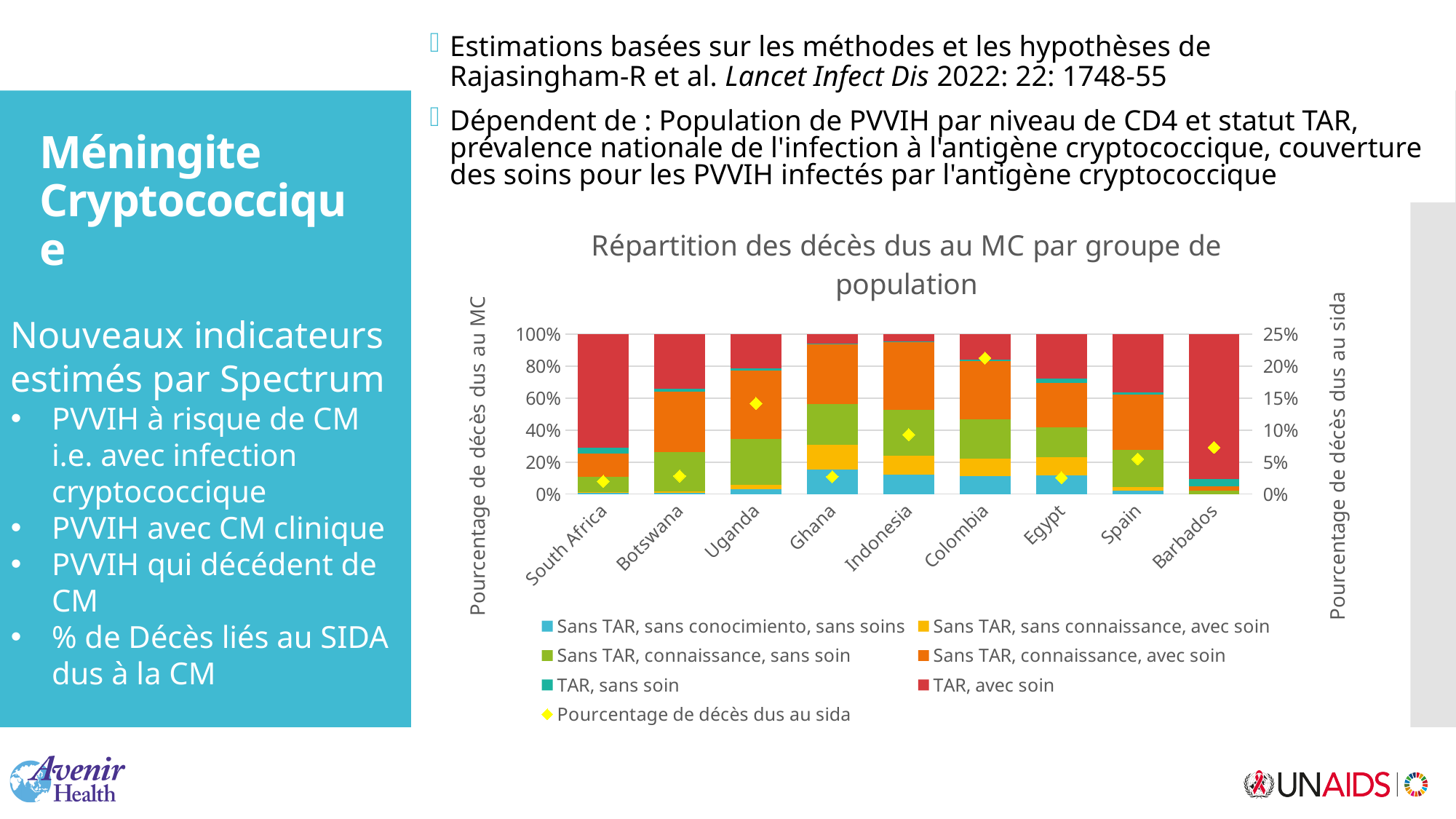
What is the title of the chart? Répartition des décès dus au MC par groupe de population Is the 'Pourcentage de décès dus au sida' value for South Africa greater or less than 5%? less How many countries are shown on the x axis of the chart? 9 Which has a higher 'Pourcentage de décès dus au sida' value, Colombia or Spain? Colombia What kind of chart is shown on the slide? combination chart: a 100% stacked bar chart with a marker (line) series on a secondary axis Is the 'Pourcentage de décès dus au sida' value for Colombia greater or less than 15%? greater Is the 'TAR, avec soin' share for Barbados greater or less than 80%? greater How many series does the chart's legend list? 7 What is the maximum value shown on the right-hand vertical axis? 25% Which country has the largest 'TAR, avec soin' (red) share of deaths? Barbados Which country has the highest value for 'Pourcentage de décès dus au sida' (yellow diamonds)? Colombia